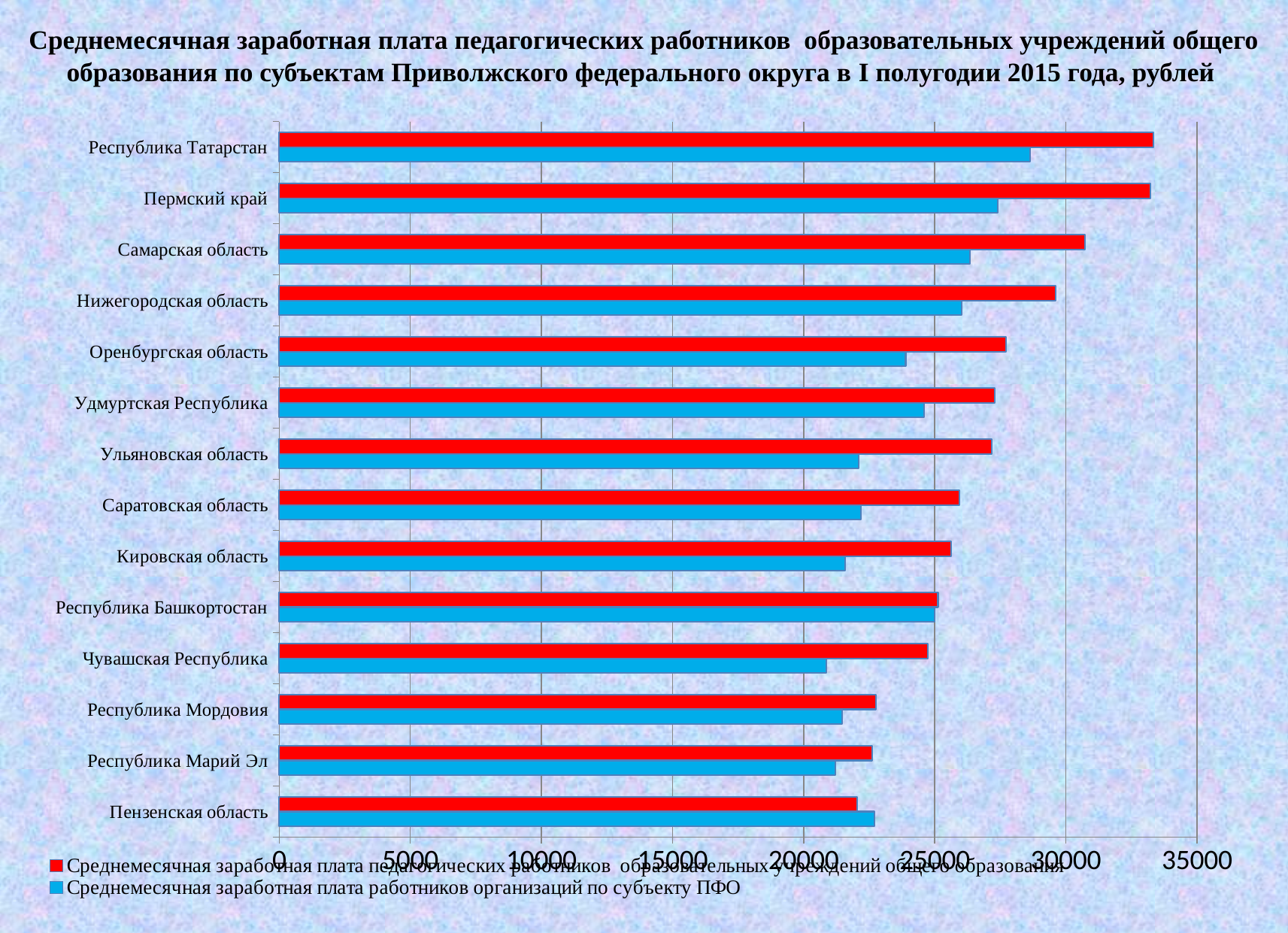
Which region has the highest value for the series 'Среднемесячная заработная плата работников организаций по субъекту ПФО' (blue bars)? Республика Татарстан Is the value for Республика Татарстан in the series 'Среднемесячная заработная плата педагогических работников образовательных учреждений общего образования' greater or less than 30000? greater How many regions (categories) are listed on the chart? 14 For Ульяновская область, which series has the larger value: the teachers' salary (red) or the salary of organisation workers in the region (blue)? teachers' salary (red) How many series does the legend list? 2 For Пензенская область, which series has the larger value: the teachers' salary (red) or the salary of organisation workers in the region (blue)? salary of organisation workers (blue) Is the value for Самарская область in the series 'Среднемесячная заработная плата педагогических работников образовательных учреждений общего образования' greater or less than 30000? greater What kind of chart is shown on the slide? bar chart Is the value for Оренбургская область in the series 'Среднемесячная заработная плата работников организаций по субъекту ПФО' greater or less than 25000? less What colour represents the series 'Среднемесячная заработная плата педагогических работников образовательных учреждений общего образования'? red